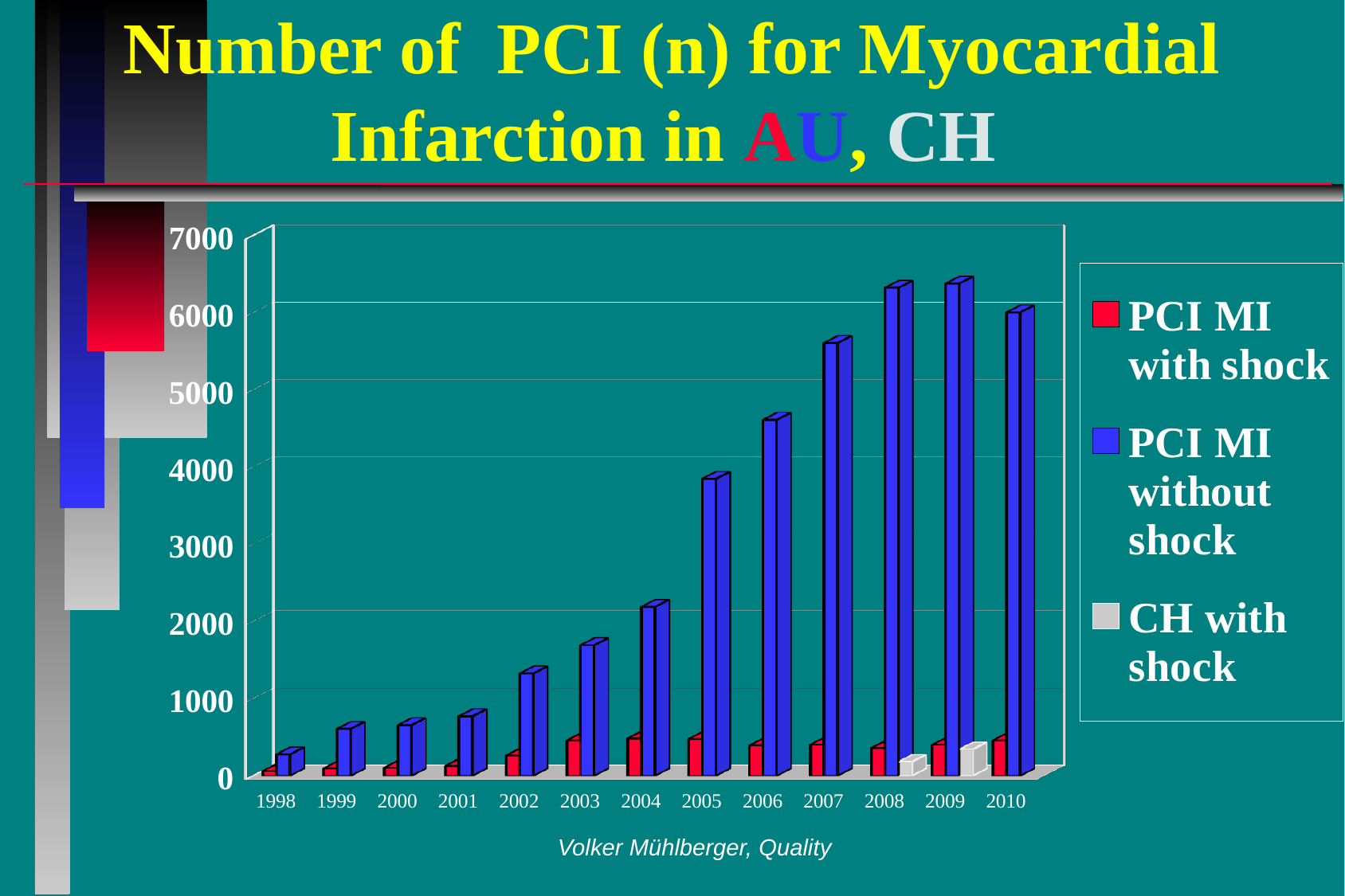
Is the value for PCI MI without shock in 2003 greater or less than 2000? less Does the PCI MI without shock series generally rise or fall from 1998 to 2009? rise Which year has the lowest value for PCI MI without shock? 1998 What kind of chart is shown on the slide? bar chart Is the value for PCI MI without shock in 2006 greater or less than 4000? greater Which is larger, PCI MI without shock in 2007 or in 2010? 2010 How many years are shown on the x axis? 13 Is the value for PCI MI without shock in 1999 greater or less than 1000? less How many series does the legend list? 3 In which years does the CH with shock series show a visible bar? 2008 and 2009 Which is larger, PCI MI without shock in 2005 or in 2006? 2006